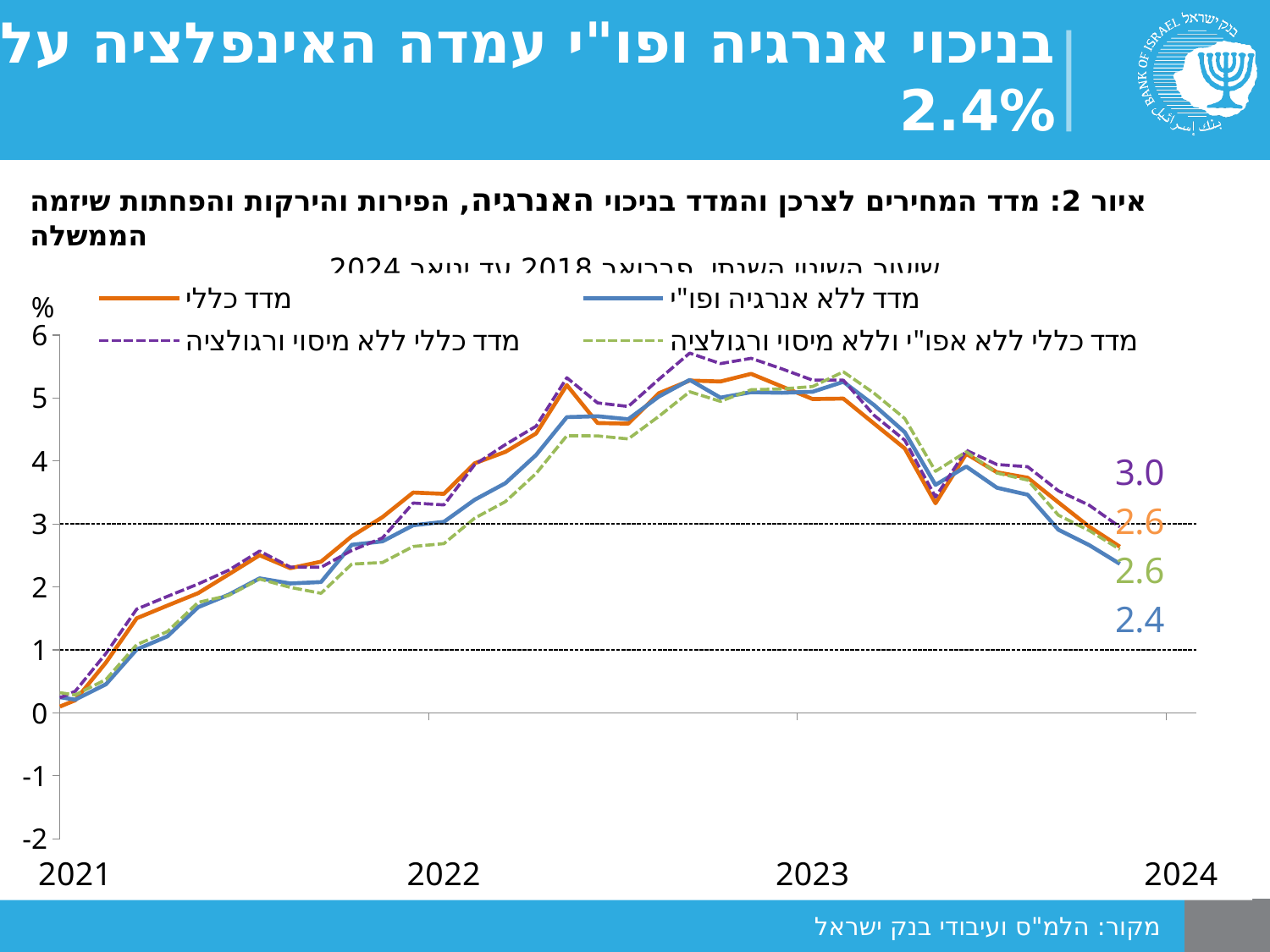
What is the difference between the end values of מדד כללי ללא מיסוי ורגולציה (3.0) and מדד ללא אנרגיה ופו"י (2.4)? 0.6 What is the latest value shown for the series מדד כללי ללא מיסוי ורגולציה (purple dashed line)? 3.0 Do the series rise or fall between 2021 and 2022? Rise What source is cited at the bottom of the slide? הלמ"ס ועיבודי בנק ישראל How many series does the legend list? 4 At the end of the chart, which is larger: the value of מדד כללי or the value of מדד ללא אנרגיה ופו"י? מדד כללי Which series has the lowest value at the end of the chart? מדד ללא אנרגיה ופו"י Which series has the highest value at the end of the chart? מדד כללי ללא מיסוי ורגולציה What is the latest value shown for the series מדד כללי (orange line)? 2.6 What is the latest value shown for the series מדד ללא אנרגיה ופו"י (blue line)? 2.4 What kind of chart is shown on the slide? Line chart